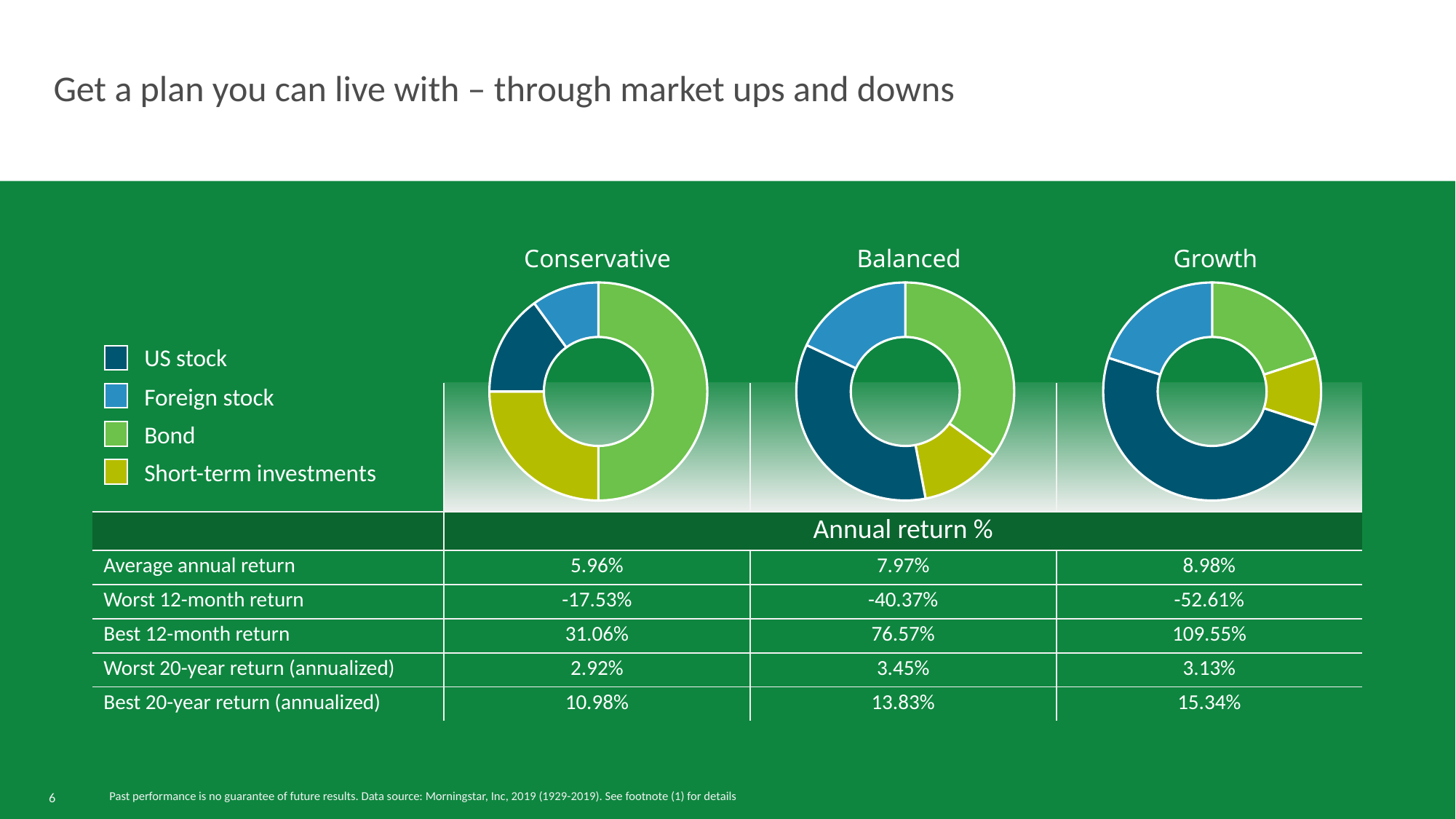
In the Growth chart, which asset class has the largest slice? US stock In the Growth chart, which asset class has the smallest slice? Short-term investments How many series does the legend list for the allocation charts? 4 In the Conservative chart, which slice is larger: Short-term investments or US stock? Short-term investments In the Conservative chart, which asset class has the smallest slice? Foreign stock What kind of chart is used to show the Conservative, Balanced and Growth allocations? Donut (pie) chart What is the worst 12-month return shown for the Growth portfolio? -52.61% How many donut charts are shown on the slide? 3 What is the average annual return shown for the Balanced portfolio? 7.97% In the Conservative chart, which asset class has the largest slice? Bond Which colour represents Bond in the legend? Light green In the Balanced chart, which slice is larger: Foreign stock or Short-term investments? Foreign stock